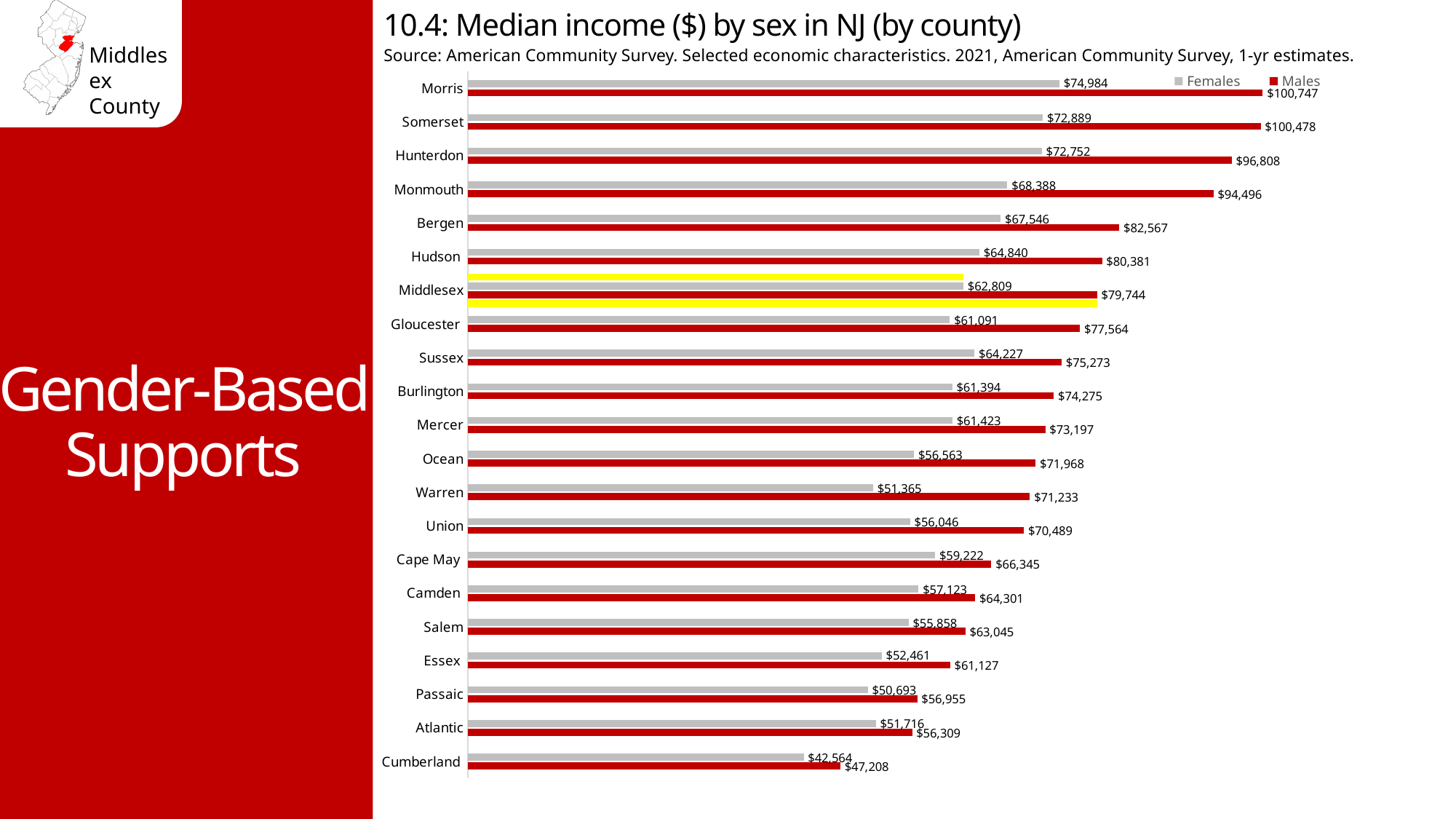
How many counties are shown in the chart? 21 What is the difference between male and female median income in Middlesex County? $16,935 What kind of chart is shown on the slide? Bar chart What is the median income for males in Cumberland County? $47,208 Which is larger: the female median income in Sussex County or in Gloucester County? Sussex What is the difference between male and female median income in Morris County? $25,763 What is the median income for males in Middlesex County? $79,744 How many series does the legend list? 2 Which county has the highest median income for males? Morris Which county has the lowest median income for females? Cumberland What is the median income for females in Middlesex County? $62,809 What is the median income for females in Bergen County? $67,546